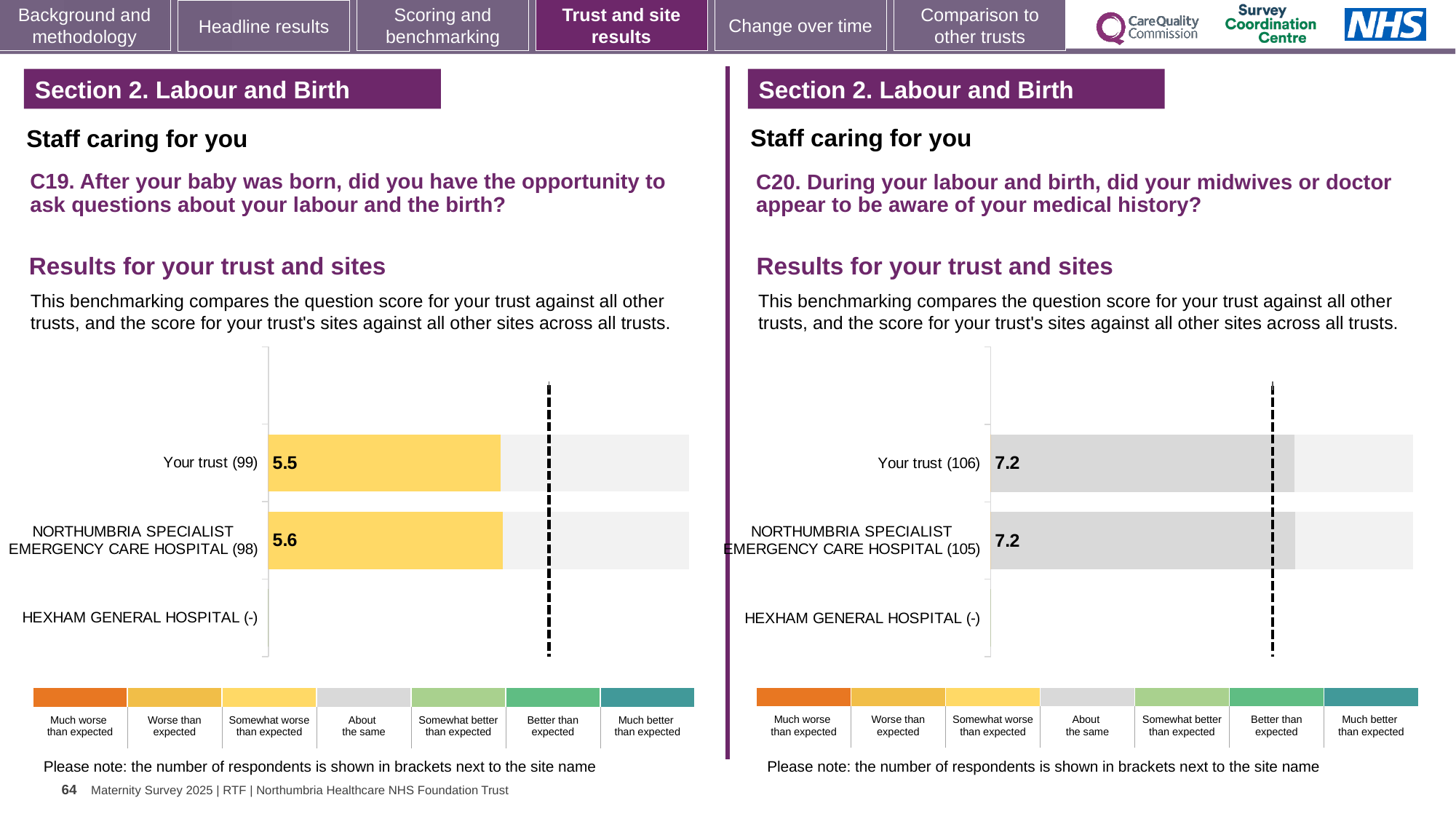
In the C19 chart on the left, how many respondents are shown in brackets for Your trust? 99 In the C19 chart on the left, what is the score for Northumbria Specialist Emergency Care Hospital? 5.6 How many site/trust rows are listed in the C19 chart on the left? 3 In the C20 chart on the right, what is the difference between the score for Your trust and the score for Northumbria Specialist Emergency Care Hospital? 0 In the C19 chart on the left, what is the difference between the score for Northumbria Specialist Emergency Care Hospital and the score for Your trust? 0.1 What kind of chart is used in the C20 chart on the right? Bar chart In the C20 chart on the right, what is the score for Your trust? 7.2 In the C19 chart on the left, which benchmark category does the yellow colour of the bars correspond to in the legend? Somewhat worse than expected In the C20 chart on the right, what is the score for Northumbria Specialist Emergency Care Hospital? 7.2 In the C19 chart on the left, what is the score for Your trust? 5.5 In the C20 chart on the right, how many respondents are shown in brackets for Northumbria Specialist Emergency Care Hospital? 105 In the C19 chart on the left, which has the higher score: Your trust or Northumbria Specialist Emergency Care Hospital? Northumbria Specialist Emergency Care Hospital